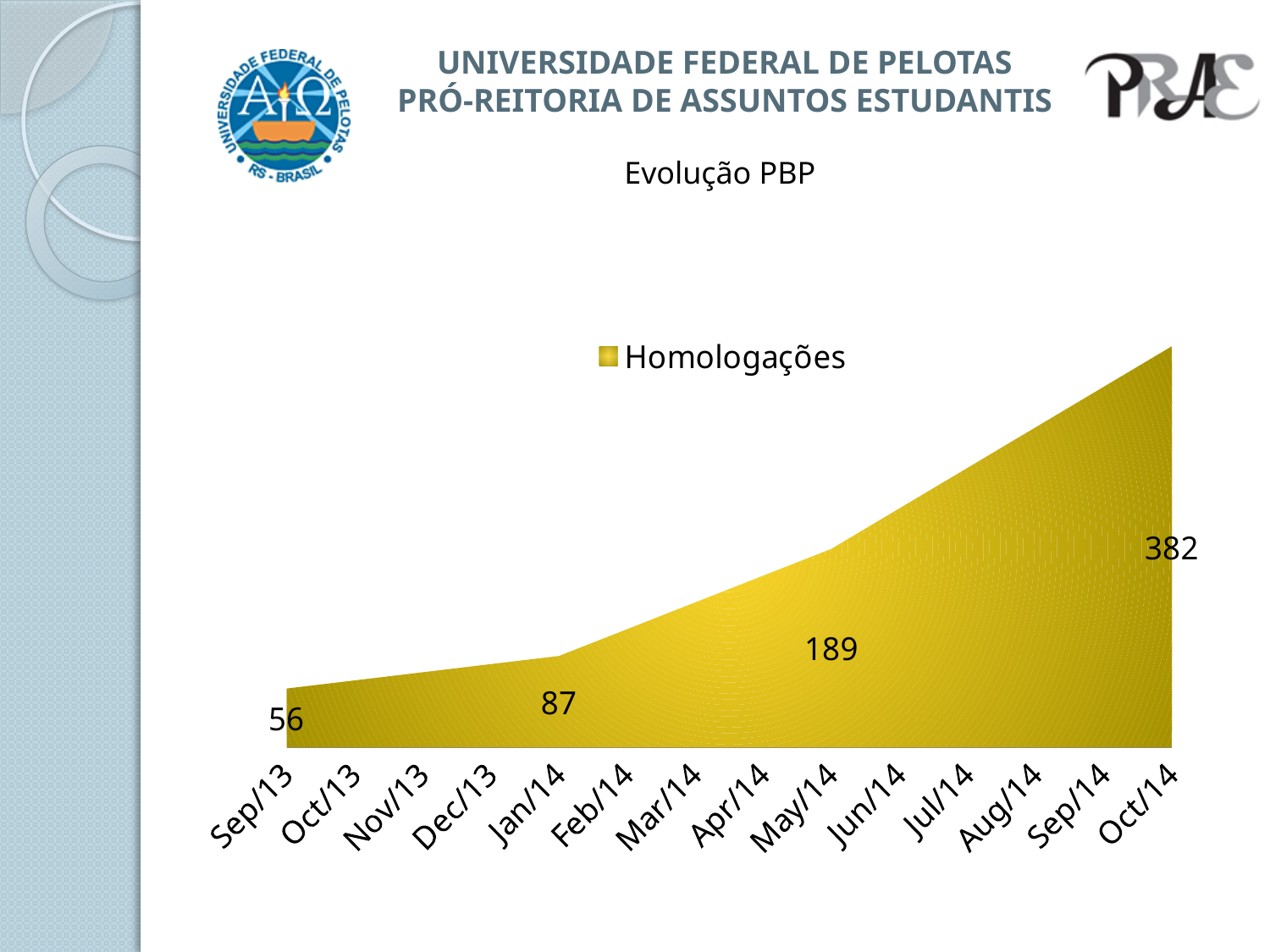
What is the value for Sep/13 in the Evolução PBP chart? 56 How many months are shown on the x axis of the Evolução PBP chart? 14 Which month has the highest value in the Evolução PBP chart? Oct/14 Which is larger in the Evolução PBP chart, the value for May/14 or the value for Jan/14? May/14 What is the value for Jan/14 in the Evolução PBP chart? 87 What is the value for May/14 in the Evolução PBP chart? 189 What is the value for Oct/14 in the Evolução PBP chart? 382 What series name does the legend of the Evolução PBP chart show? Homologações What is the difference between the values for Oct/14 and May/14 in the Evolução PBP chart? 193 Which month has the lowest value in the Evolução PBP chart? Sep/13 Do the values in the Evolução PBP chart rise or fall from Sep/13 to Oct/14? rise What is the difference between the values for Jan/14 and Sep/13 in the Evolução PBP chart? 31